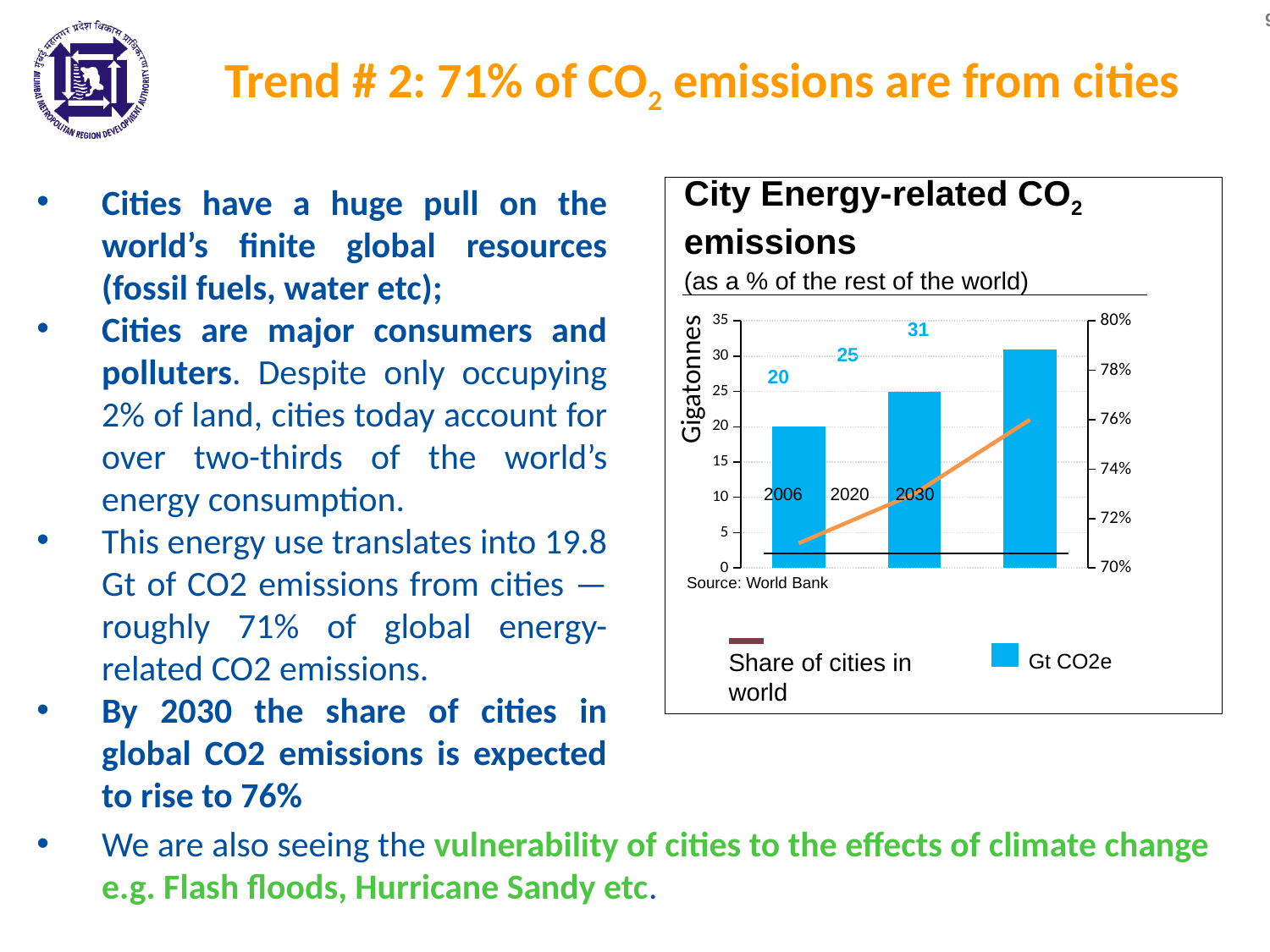
Which year has the highest Gt CO2e value? 2030 Which year has the lowest Gt CO2e value? 2006 What is the Gt CO2e value for 2006? 20 What is the difference in Gt CO2e between 2030 and 2006? 11 How many series does the chart legend list? 2 Which is larger, the Gt CO2e value for 2020 or for 2006? 2020 What kind of chart is used to show the Gt CO2e values? bar chart Do the Gt CO2e values rise or fall from 2006 to 2030? rise What is the Gt CO2e value for 2020? 25 Is the share of cities in world for 2030 greater or less than 74%? greater What is the Gt CO2e value for 2030? 31 How many years are shown on the x axis of the chart? 3